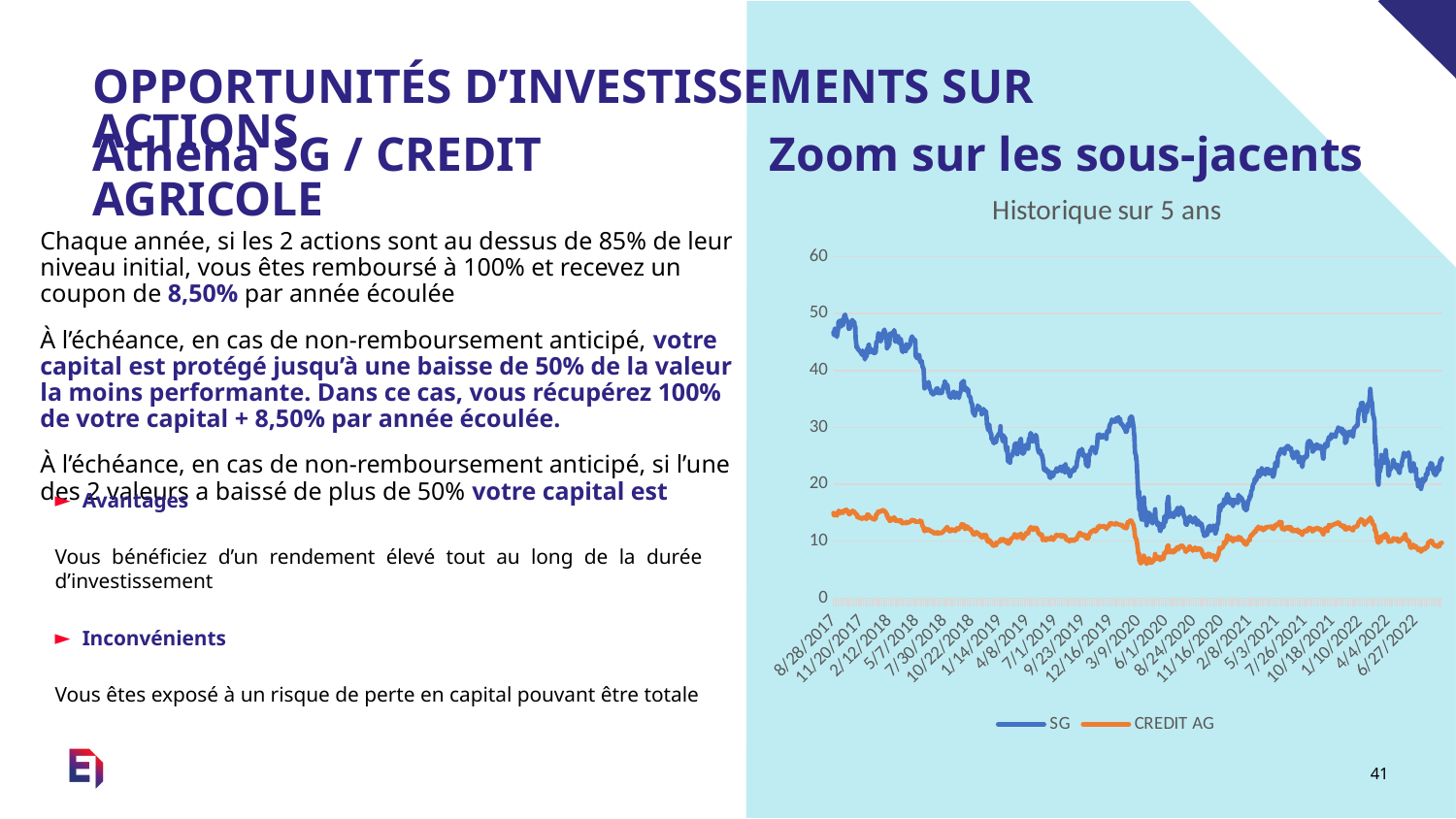
What is the title of the chart on the right side of the slide? Historique sur 5 ans What are the two series named in the legend of the 'Historique sur 5 ans' chart? SG and CREDIT AG How many series does the legend of the 'Historique sur 5 ans' chart list? 2 In the 'Historique sur 5 ans' chart, is the value for SG at 6/27/2022 greater or less than 30? less In the 'Historique sur 5 ans' chart, which series stays above the other across the whole period, SG or CREDIT AG? SG In the 'Historique sur 5 ans' chart, is the value for SG at 6/1/2020 greater or less than 20? less What kind of chart is shown under 'Zoom sur les sous-jacents'? line chart In the 'Historique sur 5 ans' chart, which series has the higher value at 8/28/2017, SG or CREDIT AG? SG In the 'Historique sur 5 ans' chart, is the value for SG at 8/28/2017 greater or less than 40? greater In the 'Historique sur 5 ans' chart, does the SG series overall rise or fall between 8/28/2017 and 6/27/2022? fall